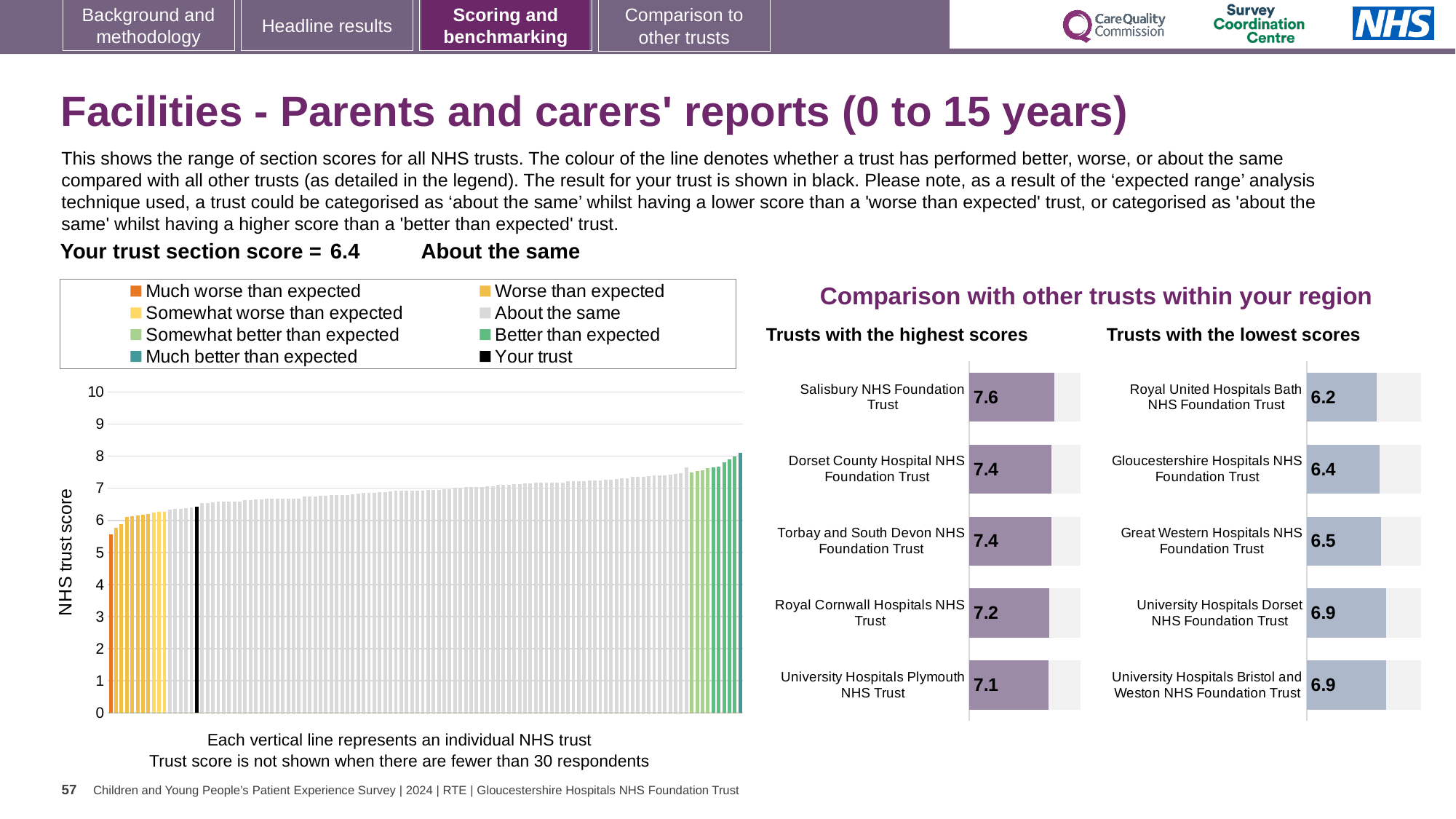
How many trusts are shown in the 'Trusts with the highest scores' chart? 5 In the large chart on the left, do the trust scores rise or fall from left to right? Rise In the 'Trusts with the lowest scores' chart, what is the difference between the scores of University Hospitals Bristol and Weston NHS Foundation Trust and Royal United Hospitals Bath NHS Foundation Trust? 0.7 In the 'Trusts with the highest scores' chart, what is the difference between the scores of Salisbury NHS Foundation Trust and University Hospitals Plymouth NHS Trust? 0.5 In the 'Trusts with the highest scores' chart, what is the score for Royal Cornwall Hospitals NHS Trust? 7.2 How many entries does the legend above the large chart on the left list? 8 In the 'Trusts with the lowest scores' chart, which trust has the lowest score? Royal United Hospitals Bath NHS Foundation Trust In the 'Trusts with the lowest scores' chart, which has the larger score: Great Western Hospitals NHS Foundation Trust or Gloucestershire Hospitals NHS Foundation Trust? Great Western Hospitals NHS Foundation Trust In the large chart on the left, what is the section score for your trust (shown in black)? 6.4 In the 'Trusts with the highest scores' chart, what is the score for Salisbury NHS Foundation Trust? 7.6 What kind of chart is the large chart on the left showing all NHS trusts? Bar chart In the 'Trusts with the highest scores' chart, which trust has the highest score? Salisbury NHS Foundation Trust